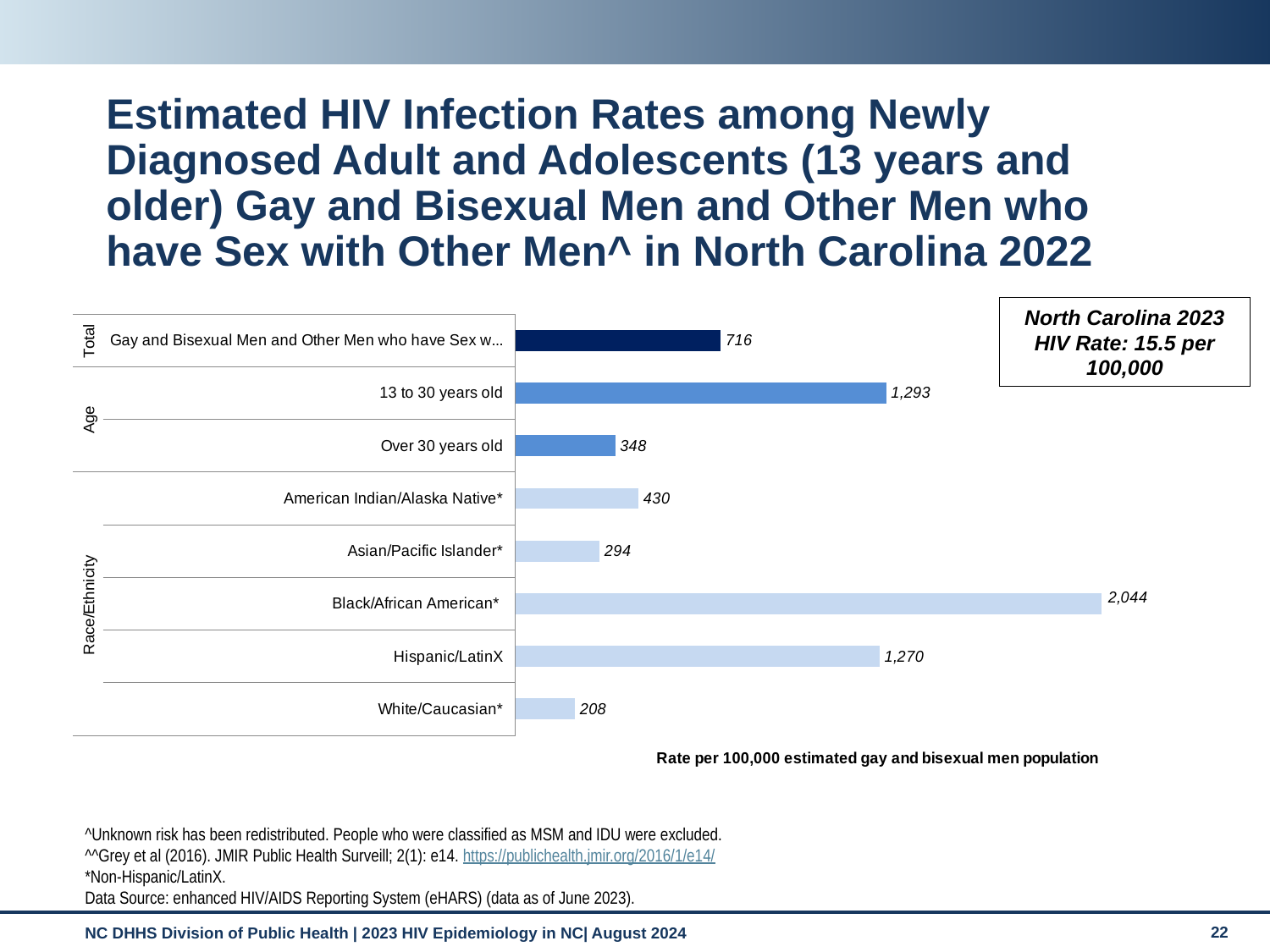
What type of chart is shown on the slide? Bar chart What is the estimated HIV infection rate for Black/African American* gay and bisexual men? 2,044 Which race/ethnicity category has the highest estimated HIV infection rate? Black/African American* Which category on the chart has the lowest estimated HIV infection rate? White/Caucasian* How many categories are plotted on the chart? 8 What is the North Carolina 2023 HIV rate shown in the text box on the slide? 15.5 per 100,000 What is the total estimated HIV infection rate for gay and bisexual men and other men who have sex with men? 716 What is the difference between the rates for Black/African American* and Hispanic/LatinX? 774 What is the estimated HIV infection rate for the 13 to 30 years old group? 1,293 Which has a higher estimated HIV infection rate, Hispanic/LatinX or American Indian/Alaska Native*? Hispanic/LatinX What is the estimated HIV infection rate for White/Caucasian* gay and bisexual men? 208 What is the difference between the rates for the 13 to 30 years old group and the Over 30 years old group? 945